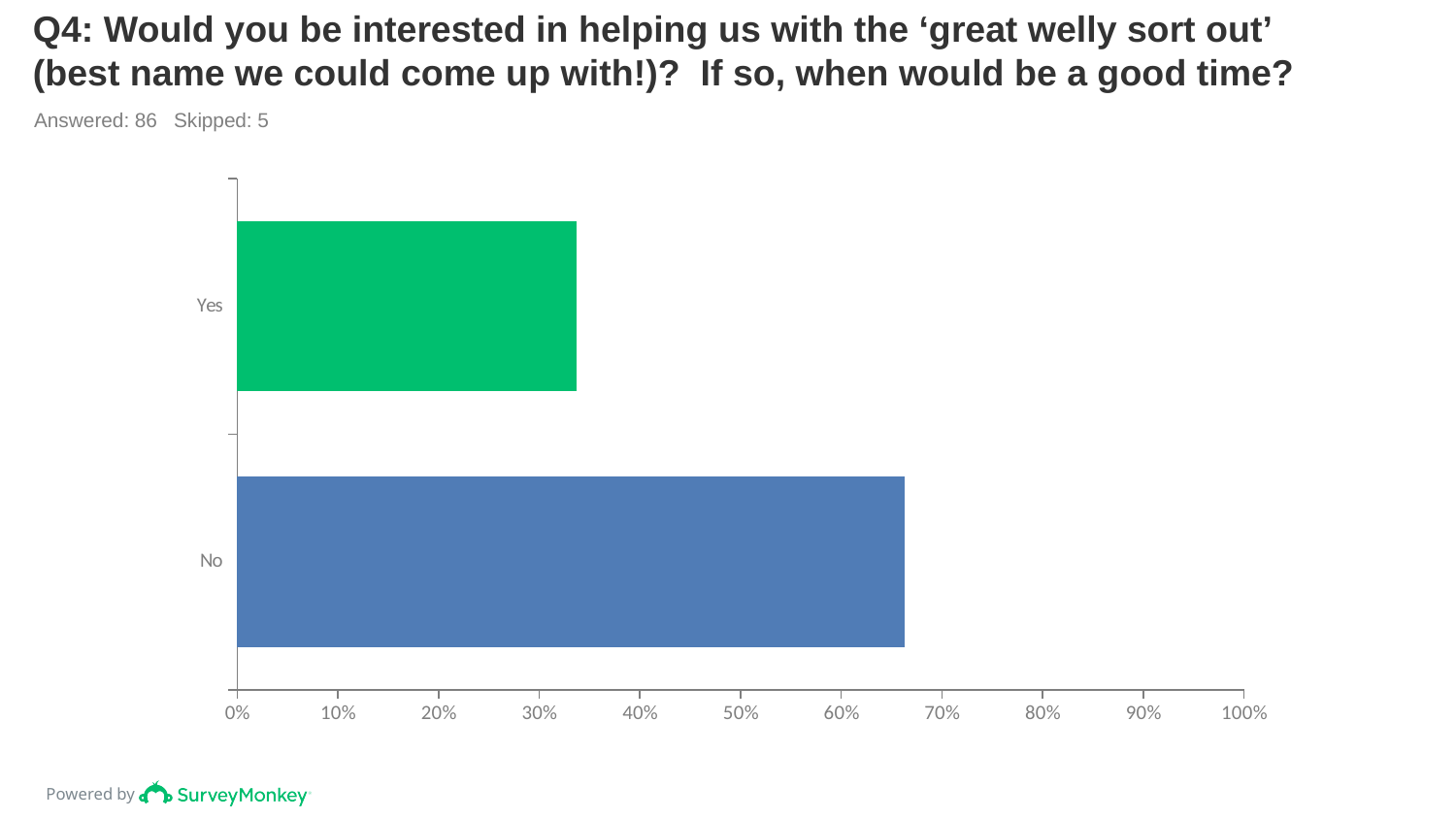
Is the value for Yes greater or less than 30%? greater Is the value for Yes greater or less than 40%? less Is the value for No greater or less than 60%? greater What colour is the bar for Yes? green Which category has the highest value? No What kind of chart is shown on the slide? bar chart Which is larger, the value for Yes or the value for No? No How many categories are plotted in the chart? 2 Which category has the lowest value? Yes How many respondents answered this question according to the slide? 86